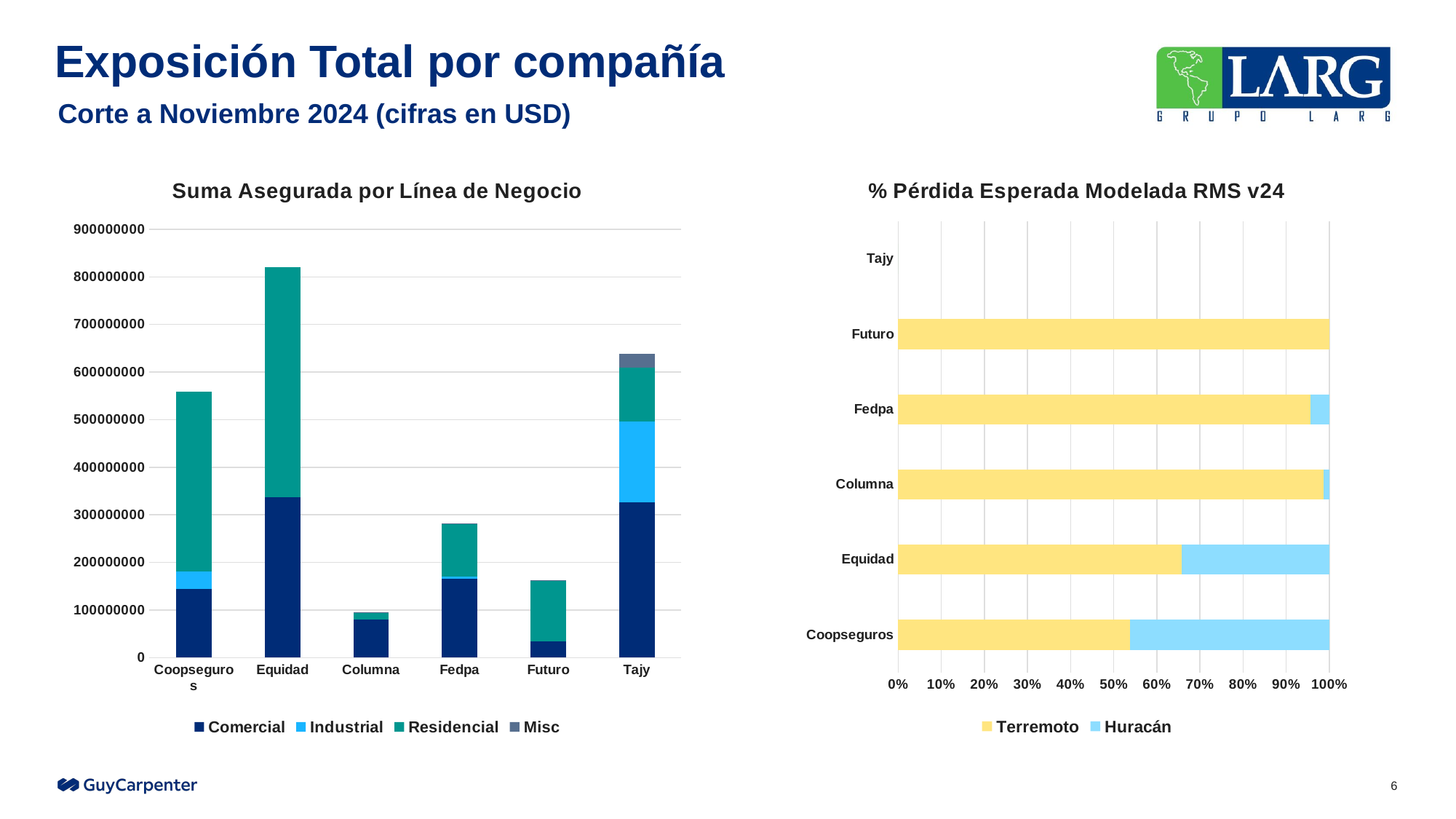
How many series does the legend of the "Suma Asegurada por Línea de Negocio" chart list? 4 In the "Suma Asegurada por Línea de Negocio" chart, is the total bar for Equidad greater or less than 700000000? greater How many companies are shown on the x axis of the "Suma Asegurada por Línea de Negocio" chart? 6 In the "% Pérdida Esperada Modelada RMS v24" chart, is the Terremoto share for Equidad greater or less than 60%? greater In the "Suma Asegurada por Línea de Negocio" chart, which company has the lowest total insured sum? Columna In the "% Pérdida Esperada Modelada RMS v24" chart, what is the Terremoto share for Futuro? 100% In the "Suma Asegurada por Línea de Negocio" chart, which company has the highest total insured sum? Equidad How many series does the legend of the "% Pérdida Esperada Modelada RMS v24" chart list? 2 What kind of chart is "Suma Asegurada por Línea de Negocio"? Stacked bar chart In the "Suma Asegurada por Línea de Negocio" chart, is the total bar for Futuro greater or less than 200000000? less In the "% Pérdida Esperada Modelada RMS v24" chart, which has the larger Huracán share, Coopseguros or Equidad? Coopseguros In the "Suma Asegurada por Línea de Negocio" chart, which series is shown in dark blue? Comercial